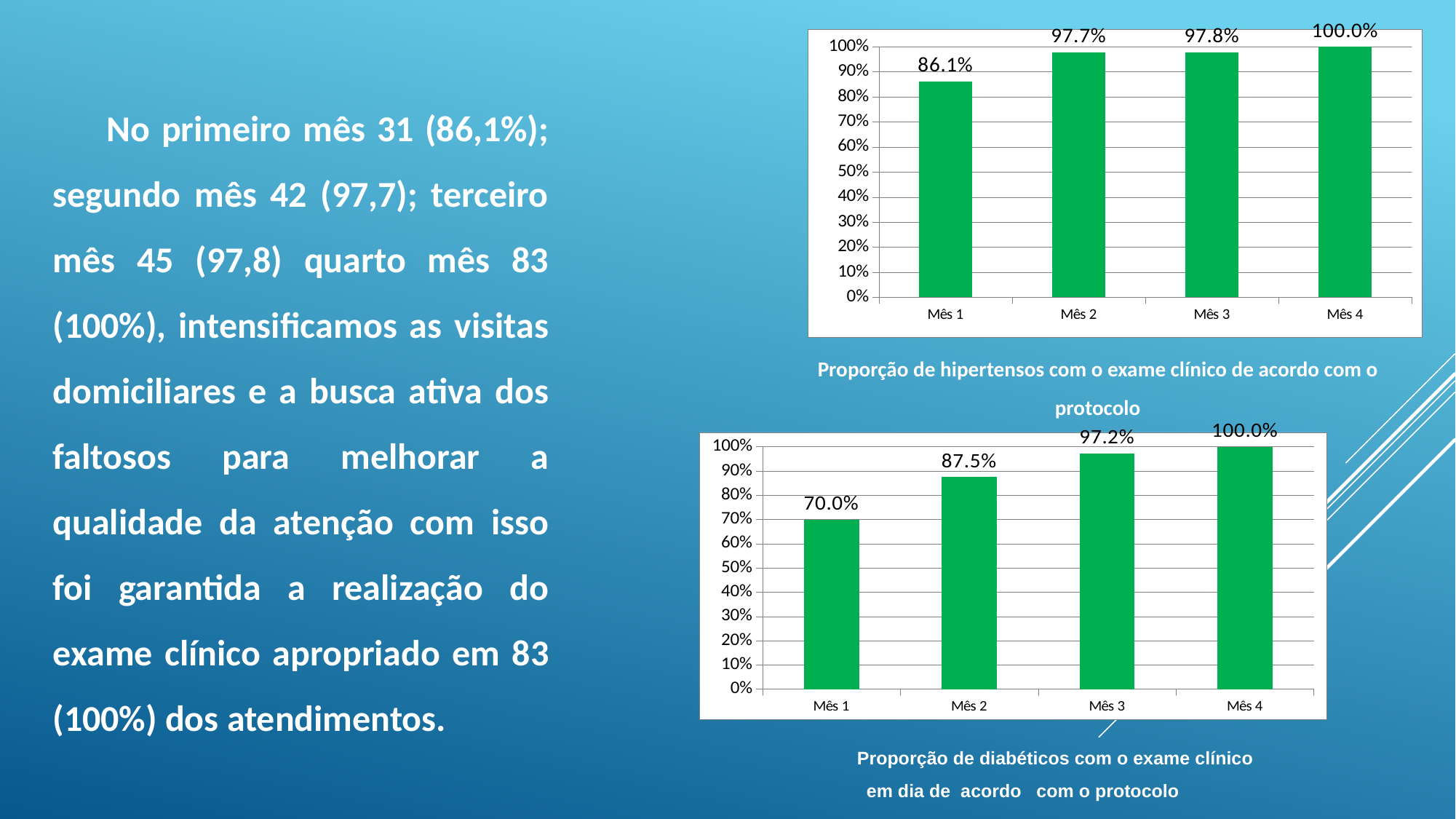
In the top chart (Proporção de hipertensos com o exame clínico de acordo com o protocolo), what is the value for Mês 1? 86.1% In the bottom chart (Proporção de diabéticos), what is the value for Mês 3? 97.2% In the top chart (Proporção de hipertensos), what is the difference between the values for Mês 4 and Mês 1? 13.9 percentage points In the bottom chart (Proporção de diabéticos com o exame clínico em dia de acordo com o protocolo), what is the value for Mês 1? 70.0% In the top chart (Proporção de hipertensos), what is the value for Mês 2? 97.7% In the bottom chart (Proporção de diabéticos), which month has the highest value? Mês 4 In the bottom chart (Proporção de diabéticos), do the values rise or fall from Mês 1 to Mês 4? rise In the top chart (Proporção de hipertensos), how many months are shown on the x axis? 4 What kind of chart is the bottom chart (Proporção de diabéticos)? bar chart In the top chart (Proporção de hipertensos), which month has the lowest value? Mês 1 In the bottom chart (Proporção de diabéticos), is the value for Mês 2 larger or smaller than the value for Mês 3? smaller In the bottom chart (Proporção de diabéticos), what is the difference between the values for Mês 2 and Mês 1? 17.5 percentage points